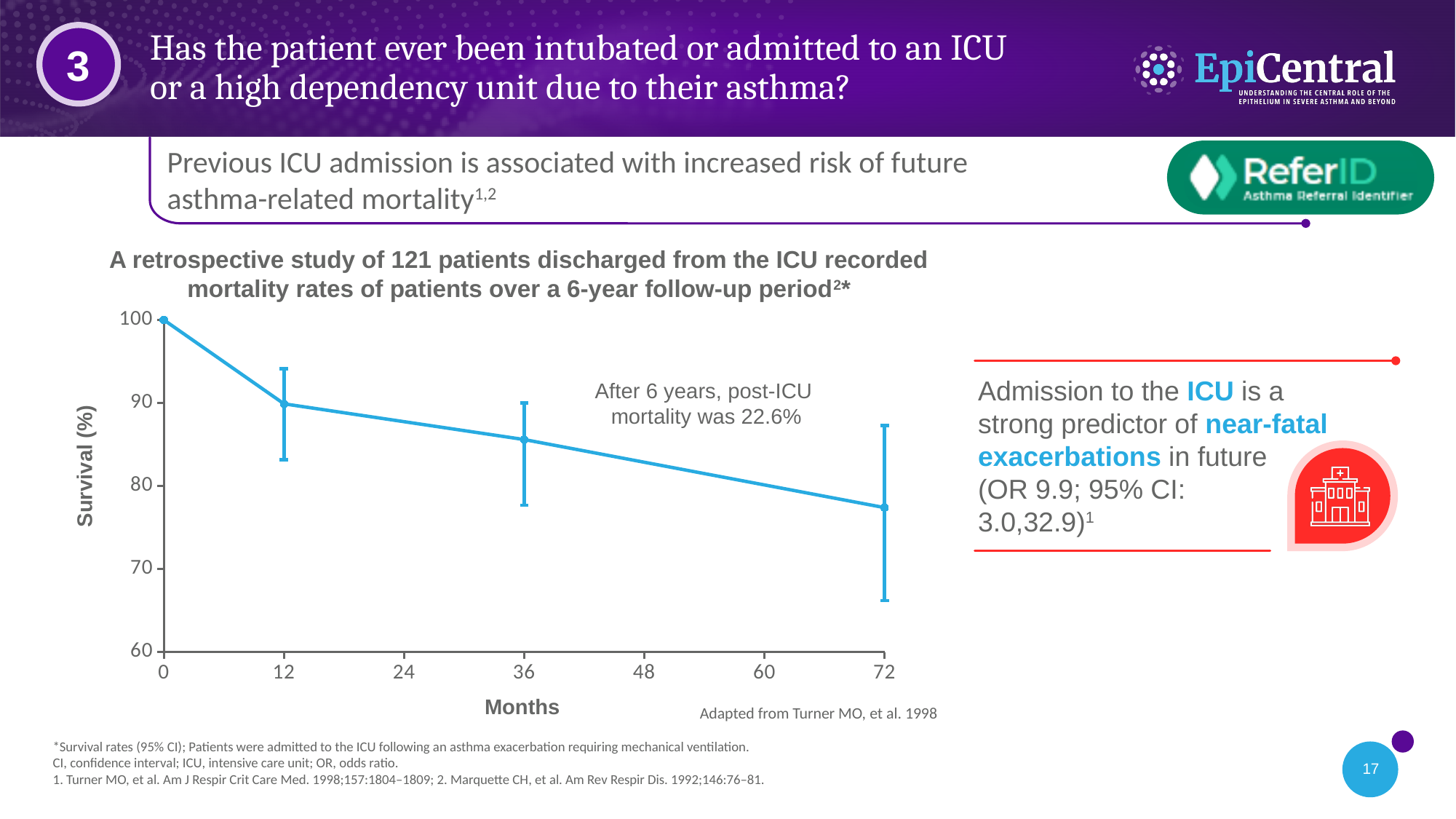
Which has the larger survival value, 12 months or 72 months? 12 months At which month is survival highest? 0 How many data points are plotted on the survival line? 4 At which month is survival lowest? 72 According to the annotation on the chart, what was post-ICU mortality after 6 years? 22.6% Is the survival value at 12 months greater or less than 80? greater What is the label of the y axis? Survival (%) Is the survival value at 72 months greater or less than 80? less Is the survival value at 36 months greater or less than 80? greater What is the survival (%) at 0 months? 100 Does survival rise or fall as months increase along the x axis? fall What kind of chart is shown on the slide? line chart